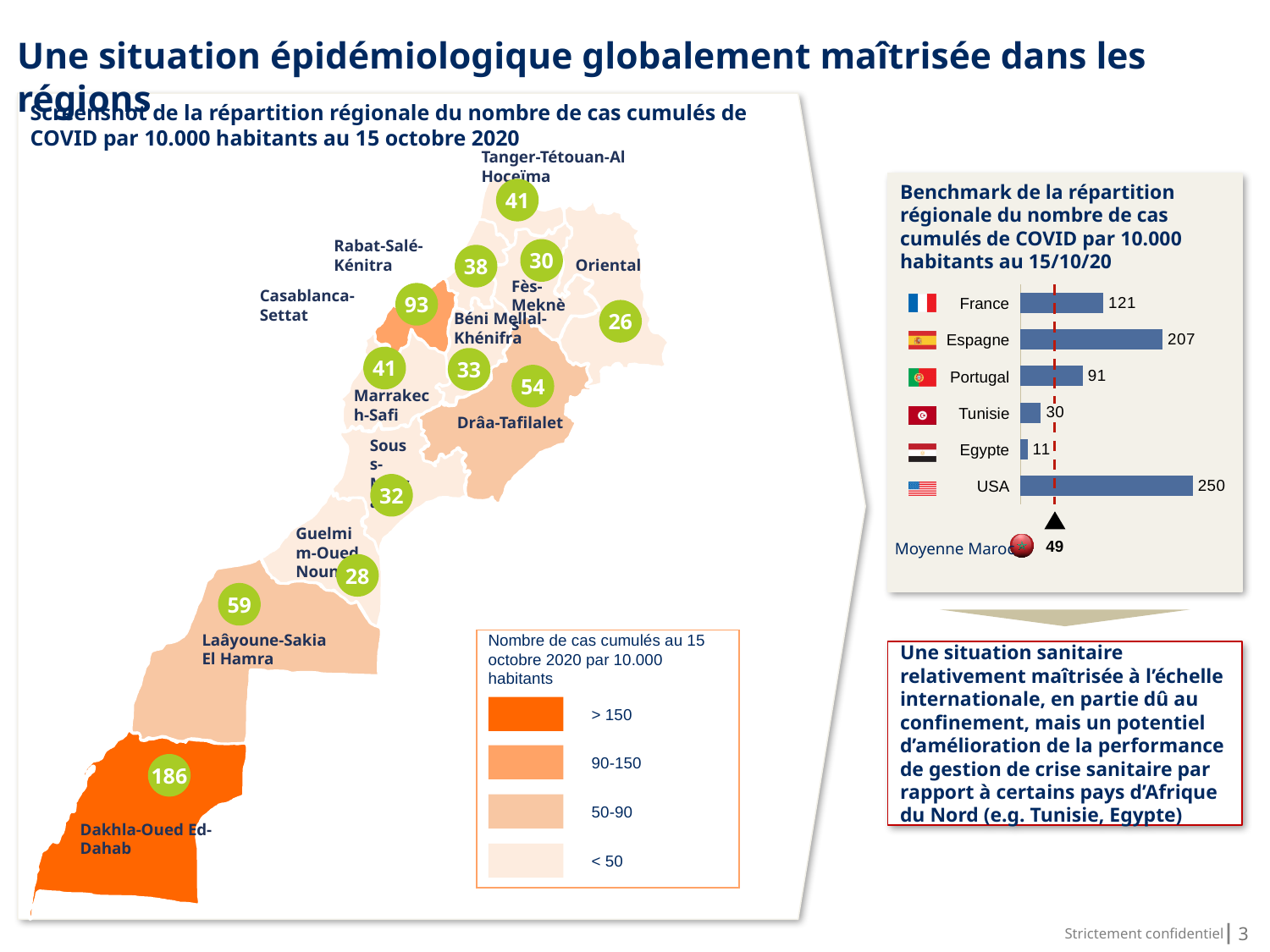
On the map on the left, what is the value shown for Dakhla-Oued Ed-Dahab? 186 In the benchmark bar chart on the right, which country has the highest value? USA On the map on the left, what is the value shown for Casablanca-Settat? 93 What kind of chart is the benchmark chart on the right of the slide? Bar chart In the benchmark bar chart on the right, what is the value for Egypte? 11 In the benchmark bar chart on the right, which country has the lowest value? Egypte In the benchmark bar chart on the right, what is the value for France? 121 In the benchmark bar chart on the right, what is the difference between the values for USA and Espagne? 43 In the benchmark bar chart on the right, which is larger, the value for Portugal or the value for Tunisie? Portugal In the benchmark bar chart on the right, what value is given for Moyenne Maroc? 49 In the benchmark bar chart on the right, what is the value for Espagne? 207 In the benchmark bar chart on the right, how many countries are shown? 6